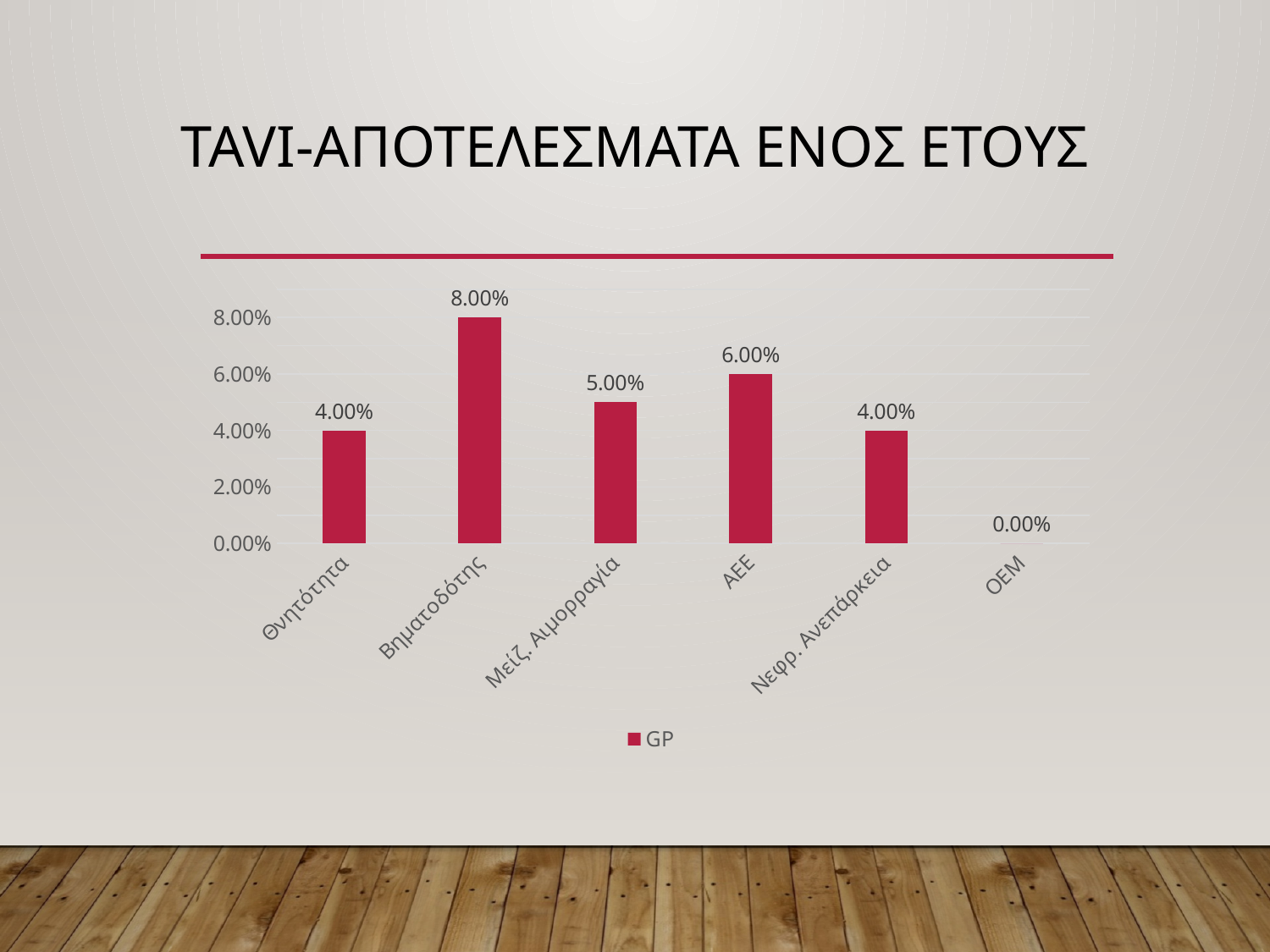
What is the name of the series shown in the legend? GP What is the value for ΟΕΜ? 0.00% What is the value for ΑΕΕ? 6.00% What is the difference between the values for Βηματοδότης and Θνητότητα? 4.00% How many series does the legend list? 1 What kind of chart is shown on the slide? bar chart Which category has the lowest value? ΟΕΜ What is the value for Βηματοδότης? 8.00% How many categories are shown on the x axis? 6 Which is larger, the value for ΑΕΕ or the value for Νεφρ. Ανεπάρκεια? ΑΕΕ Which category has the highest value? Βηματοδότης What is the value for Μείζ. Αιμορραγία? 5.00%